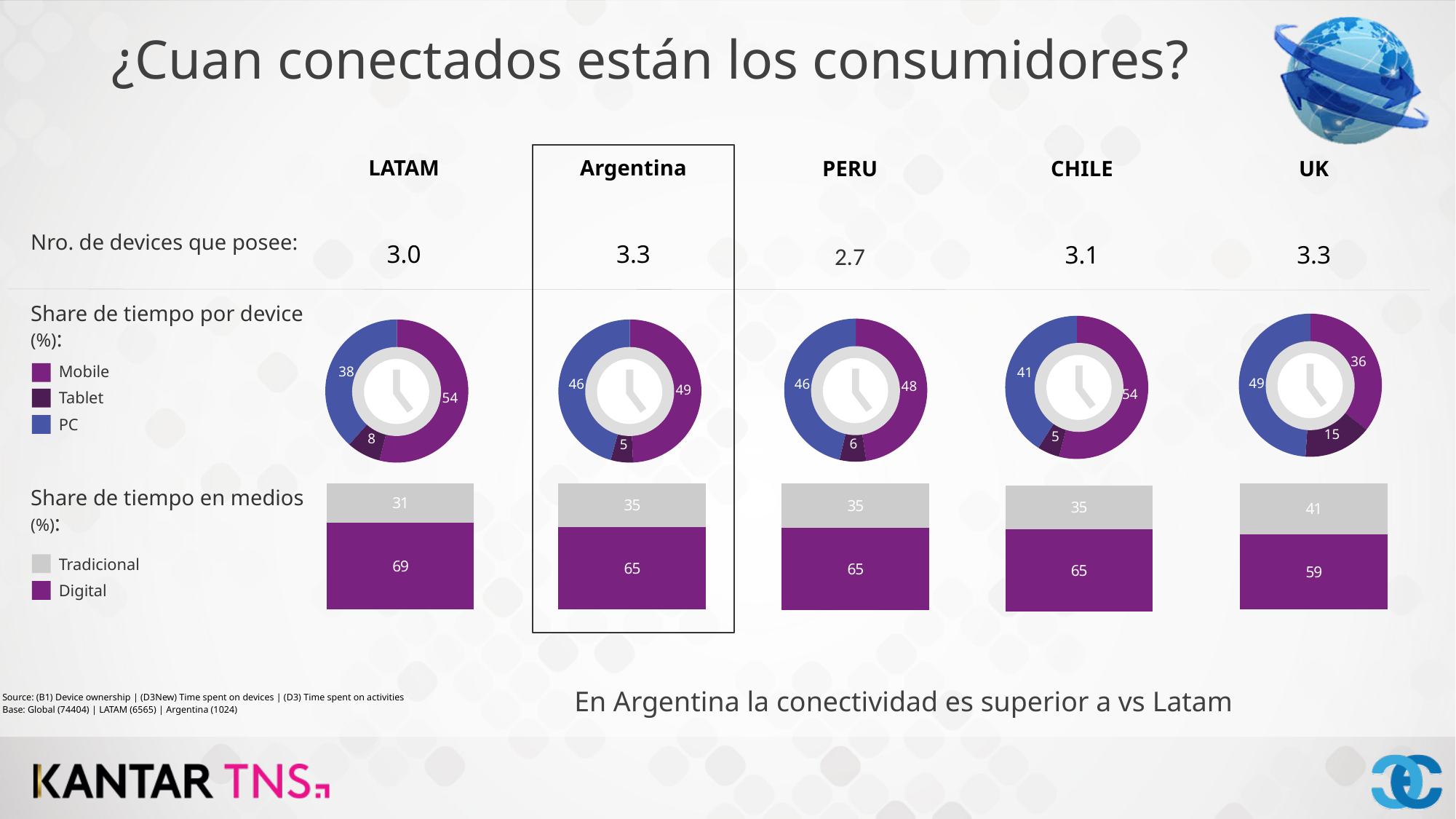
In the 'Share de tiempo por device' donut chart for UK, what is the value for Tablet? 15 How many series does the legend for the 'Share de tiempo por device' donut charts list? 3 What kind of chart is used for 'Share de tiempo en medios'? Stacked bar chart In the 'Share de tiempo por device' donut chart for Argentina, what is the value for Mobile? 49 In the 'Share de tiempo en medios' stacked bar for UK, what is the value for Tradicional? 41 In the 'Share de tiempo por device' donut chart for Peru, what is the difference between the PC value and the Tablet value? 40 In the 'Share de tiempo en medios' stacked bar for Chile, what is the value for Digital? 65 In the 'Share de tiempo por device' donut chart for LATAM, what is the value for PC? 38 Across the 'Share de tiempo por device' donut charts, which country has the lowest Mobile value? UK In the 'Share de tiempo en medios' stacked bar for Argentina, what is the total of the Tradicional and Digital segments? 100 Across the 'Share de tiempo en medios' stacked bars, which country has the highest Digital value? LATAM In the 'Share de tiempo por device' donut chart for Chile, which is larger, Mobile or PC? Mobile